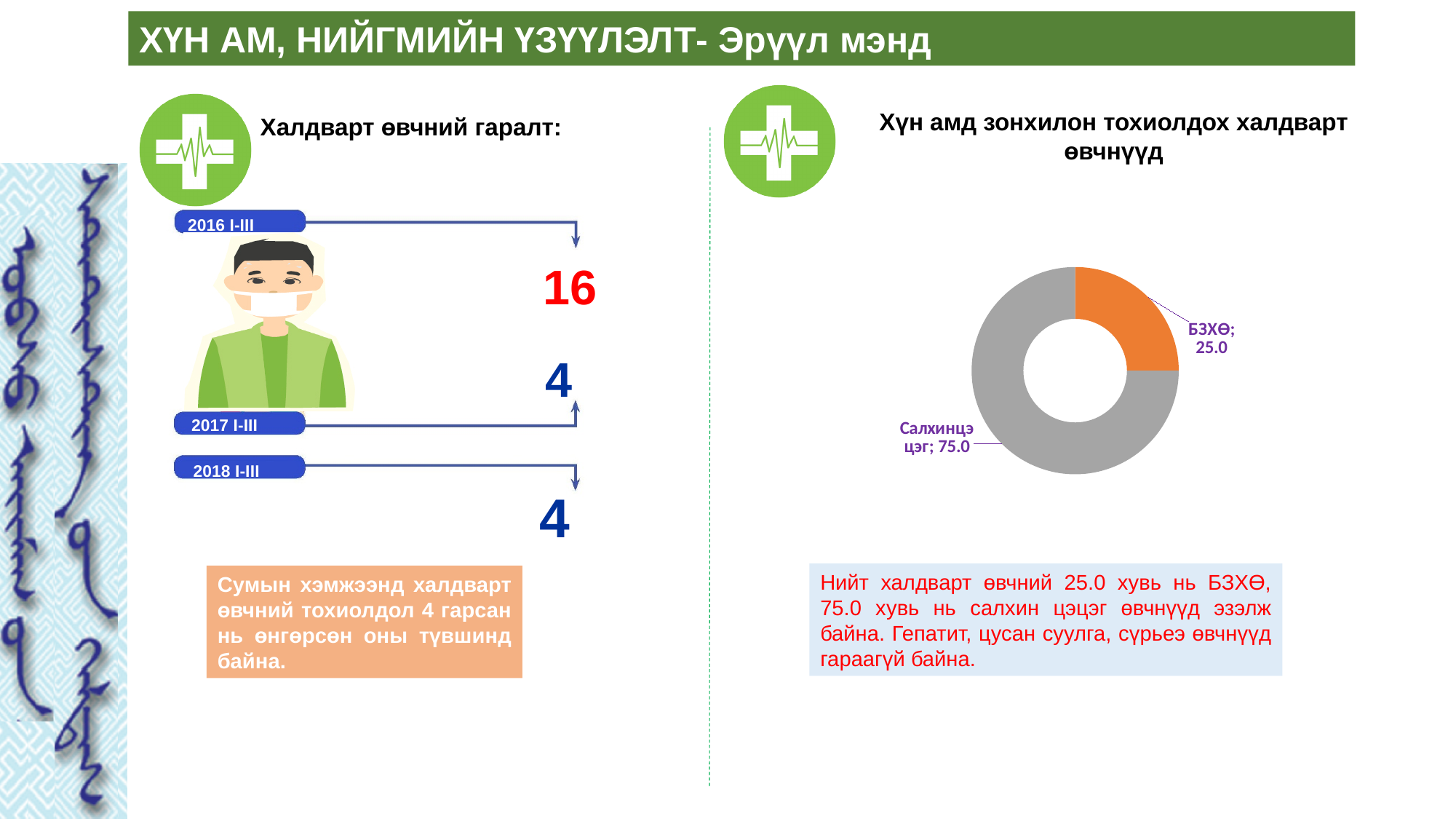
In the donut chart on the right, which is larger: БЗХӨ or Салхинцэ цэг? Салхинцэ цэг In the donut chart on the right, which category has the smallest share? БЗХӨ In the donut chart on the right, what share of the whole does the БЗХӨ slice represent? 25.0 In the donut chart on the right, what colour is the БЗХӨ slice? Orange In the donut chart on the right, how many categories (slices) are shown? 2 In the donut chart on the right, what is the value for Салхинцэ цэг? 75.0 In the donut chart on the right, which category has the largest share? Салхинцэ цэг In the infographic on the left titled 'Халдварт өвчний гаралт:', what is the value for 2016 I-III? 16 In the donut chart on the right, what is the difference between the Салхинцэ цэг value and the БЗХӨ value? 50.0 In the donut chart on the right, what is the value for БЗХӨ? 25.0 In the infographic on the left titled 'Халдварт өвчний гаралт:', do the values rise or fall from 2016 I-III to 2018 I-III? Fall What kind of chart is shown under the title 'Хүн амд зонхилон тохиолдох халдварт өвчнүүд'? Donut (pie) chart